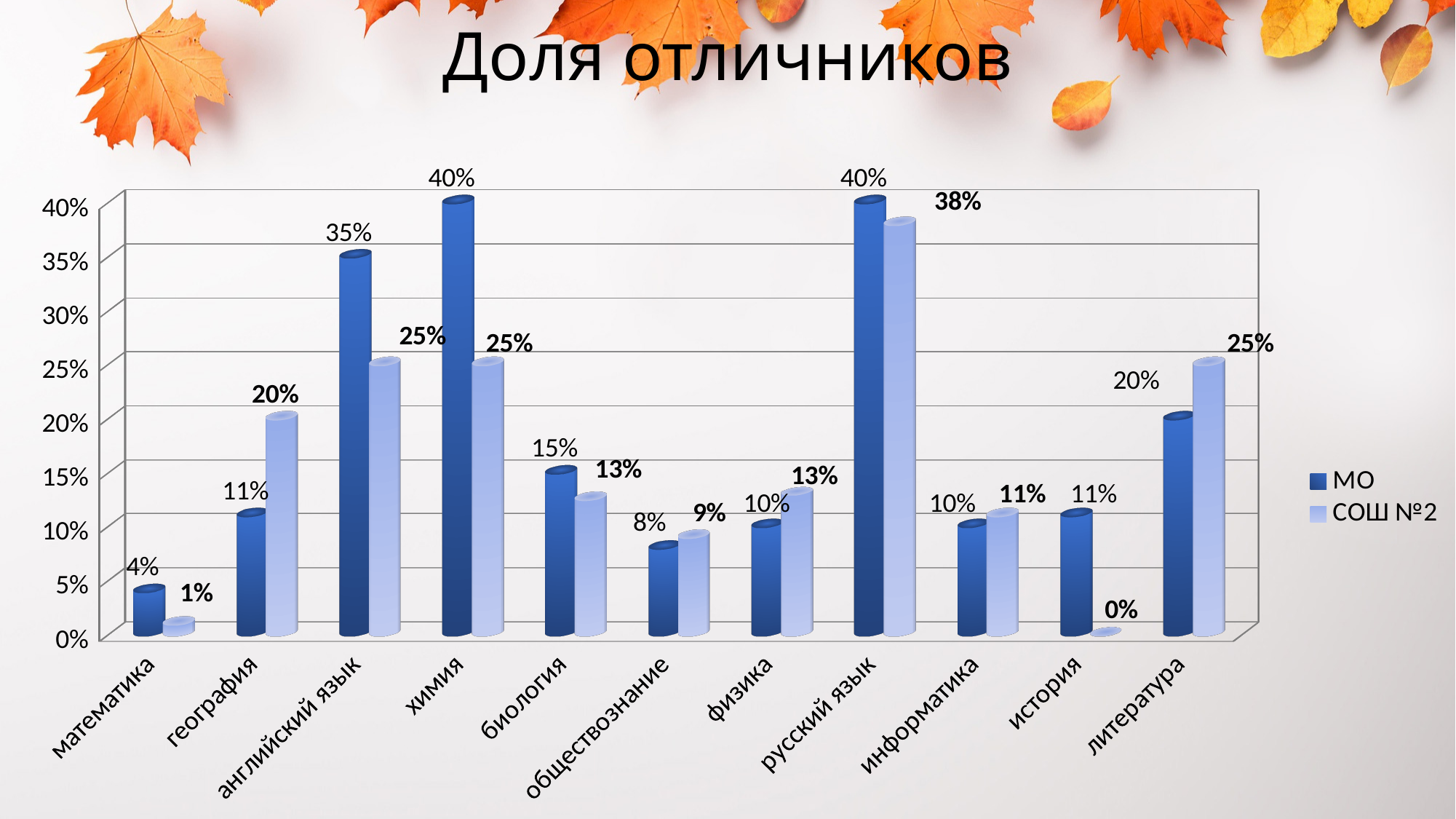
What is the title of the chart? Доля отличников Which subject has the highest value for СОШ №2? русский язык Which is larger in литература: МО or СОШ №2? СОШ №2 What is the value for СОШ №2 in география? 20% What is the difference between МО and СОШ №2 in английский язык? 10% What is the value for СОШ №2 in история? 0% How many subjects are shown on the x axis? 11 What is the value for МО in химия? 40% Is the value for МО in биология greater or less than 10%? greater What kind of chart is shown on the slide? bar chart Which subject has the lowest value for МО? математика How many series does the legend list? 2